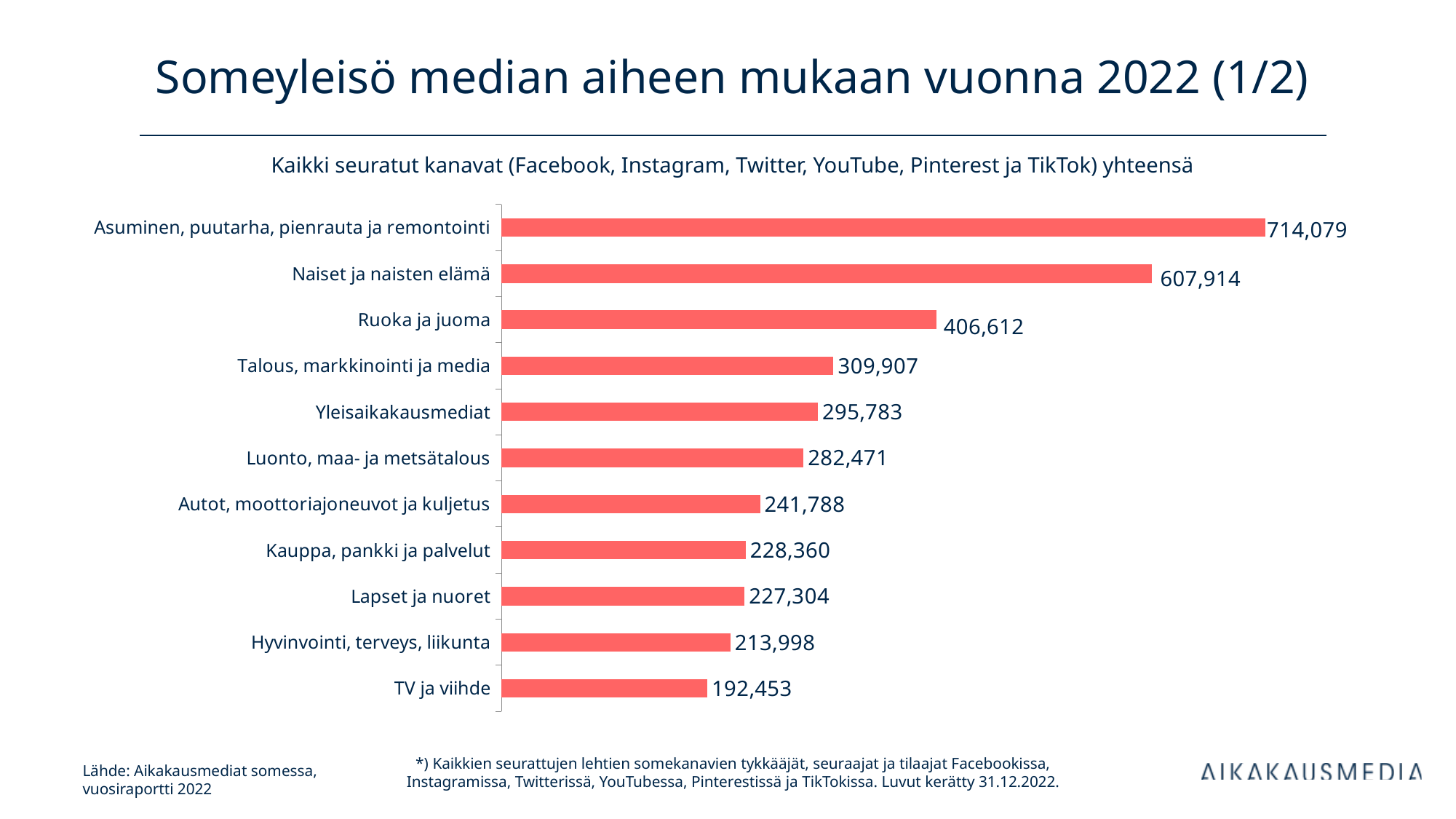
What is the value for Lapset ja nuoret? 227,304 Which category has the lowest value? TV ja viihde What is the value for Asuminen, puutarha, pienrauta ja remontointi? 714,079 Which category has the highest value? Asuminen, puutarha, pienrauta ja remontointi What is the difference between the values for Kauppa, pankki ja palvelut and Lapset ja nuoret? 1,056 What kind of chart is shown on the slide? Bar chart What is the subtitle shown above the chart? Kaikki seuratut kanavat (Facebook, Instagram, Twitter, YouTube, Pinterest ja TikTok) yhteensä What is the value for TV ja viihde? 192,453 What is the difference between the values for Naiset ja naisten elämä and Ruoka ja juoma? 201,302 How many categories are shown in the chart? 11 Which is larger, the value for Talous, markkinointi ja media or the value for Yleisaikakausmediat? Talous, markkinointi ja media What is the value for Ruoka ja juoma? 406,612